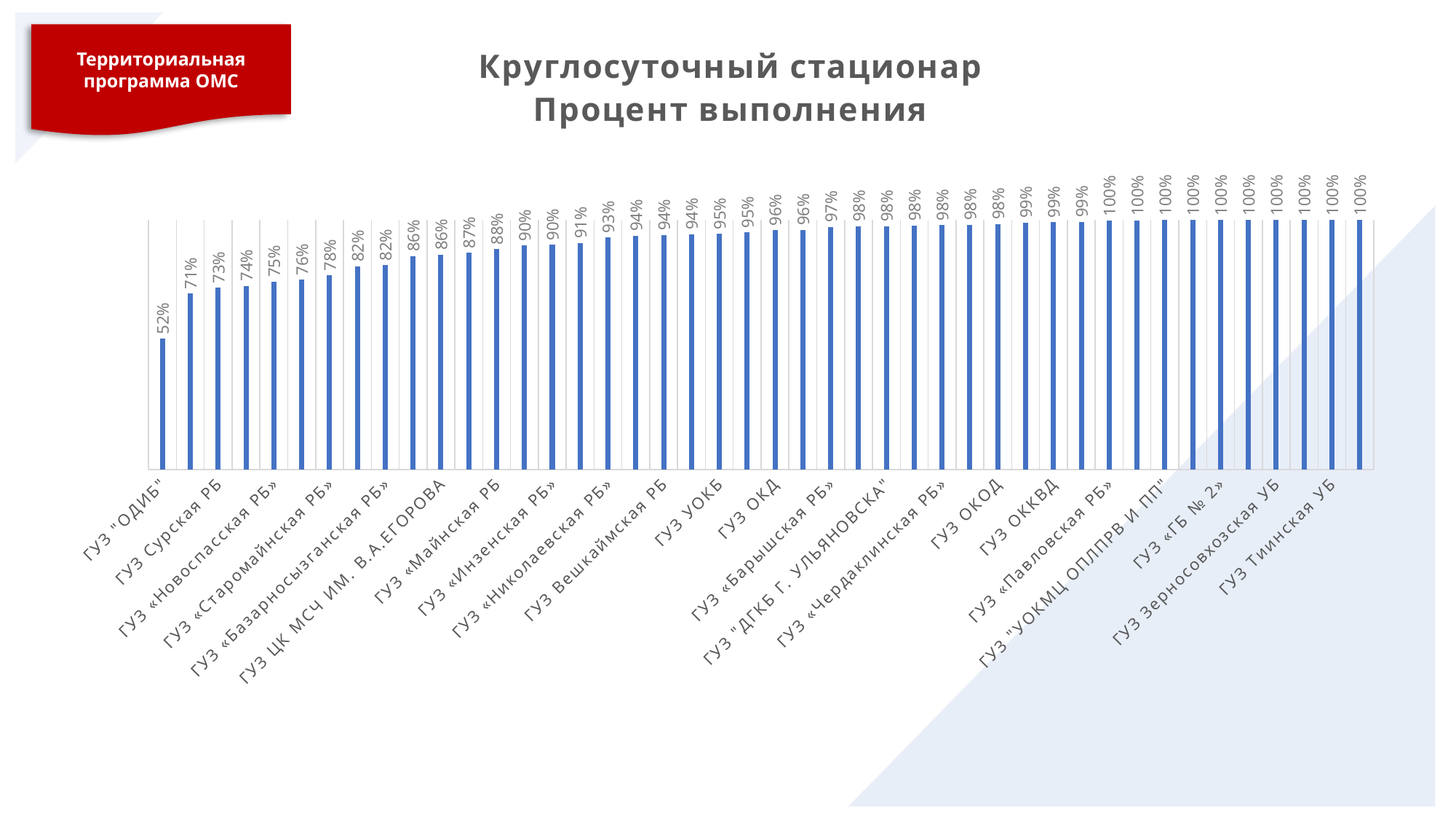
Do the values rise or fall from left to right along the x axis? rise What is the difference between the values for ГУЗ Тиинская УБ and ГУЗ "ОДИБ"? 48% What is the title of the chart? Круглосуточный стационар Процент выполнения How many bars in the chart are labelled 100%? 10 Which institution has the lowest percentage of fulfilment? ГУЗ "ОДИБ" What is the percentage of fulfilment for ГУЗ «Майнская РБ»? 88% How many bars are plotted in the chart? 44 Which is larger, the value for ГУЗ "ОДИБ" or the value for ГУЗ Сурская РБ? ГУЗ Сурская РБ What is the percentage of fulfilment for ГУЗ "ОДИБ"? 52% What kind of chart is shown on the slide? bar chart What is the percentage of fulfilment for ГУЗ Тиинская УБ? 100% What is the percentage of fulfilment for ГУЗ Сурская РБ? 73%